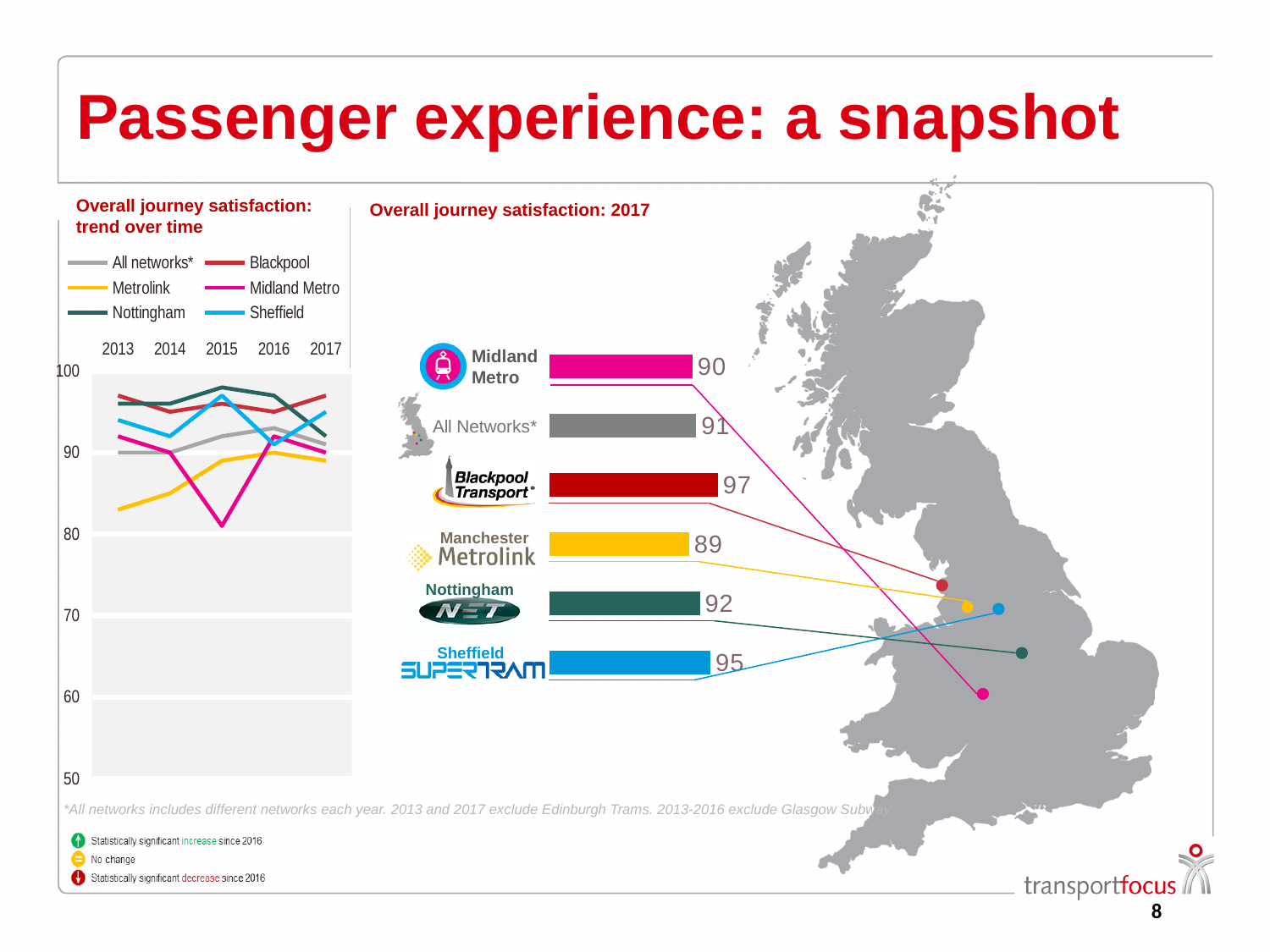
In the 'Overall journey satisfaction: 2017' chart, what is the difference between Blackpool Transport and Midland Metro? 7 In the 'Overall journey satisfaction: 2017' chart, which network has the lowest value? Manchester Metrolink In the 'Overall journey satisfaction: 2017' chart, what is the value for Manchester Metrolink? 89 What kind of chart is 'Overall journey satisfaction: 2017'? Bar chart In the 'Overall journey satisfaction: 2017' chart, which network has the highest value? Blackpool Transport In the 'Overall journey satisfaction: 2017' chart, what is the value for Blackpool Transport? 97 In the 'Overall journey satisfaction: 2017' chart, what is the value for Sheffield Supertram? 95 In the 'Overall journey satisfaction: trend over time' chart, is the value for Metrolink in 2013 greater or less than 90? less What kind of chart is 'Overall journey satisfaction: trend over time'? Line chart How many series does the legend of the 'Overall journey satisfaction: trend over time' chart list? 6 How many bars are shown in the 'Overall journey satisfaction: 2017' chart? 6 In the 'Overall journey satisfaction: 2017' chart, which is larger: Nottingham or All Networks*? Nottingham